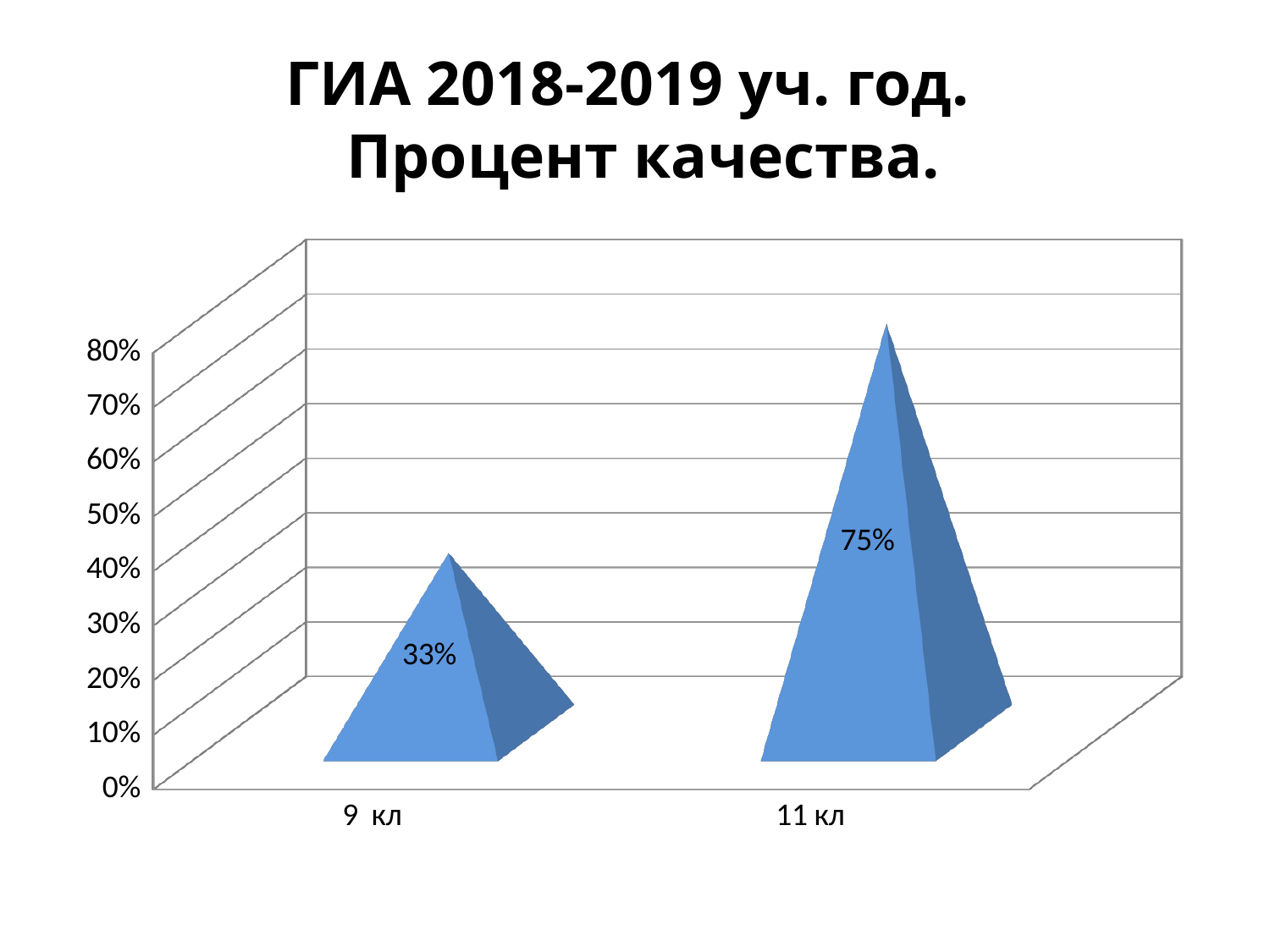
Which category has the lowest value? 9 кл Is the value for 9 кл greater or less than 40%? less What is the value for 11 кл? 75% What is the title of the chart? ГИА 2018-2019 уч. год. Процент качества. How many categories are shown on the x axis? 2 Which is larger, the value for 9 кл or the value for 11 кл? 11 кл What is the difference between the values for 11 кл and 9 кл? 42% Do the values rise or fall from 9 кл to 11 кл? rise Is the value for 11 кл greater or less than 50%? greater Which category has the highest value? 11 кл What kind of chart is shown on the slide? bar chart What is the value for 9 кл? 33%